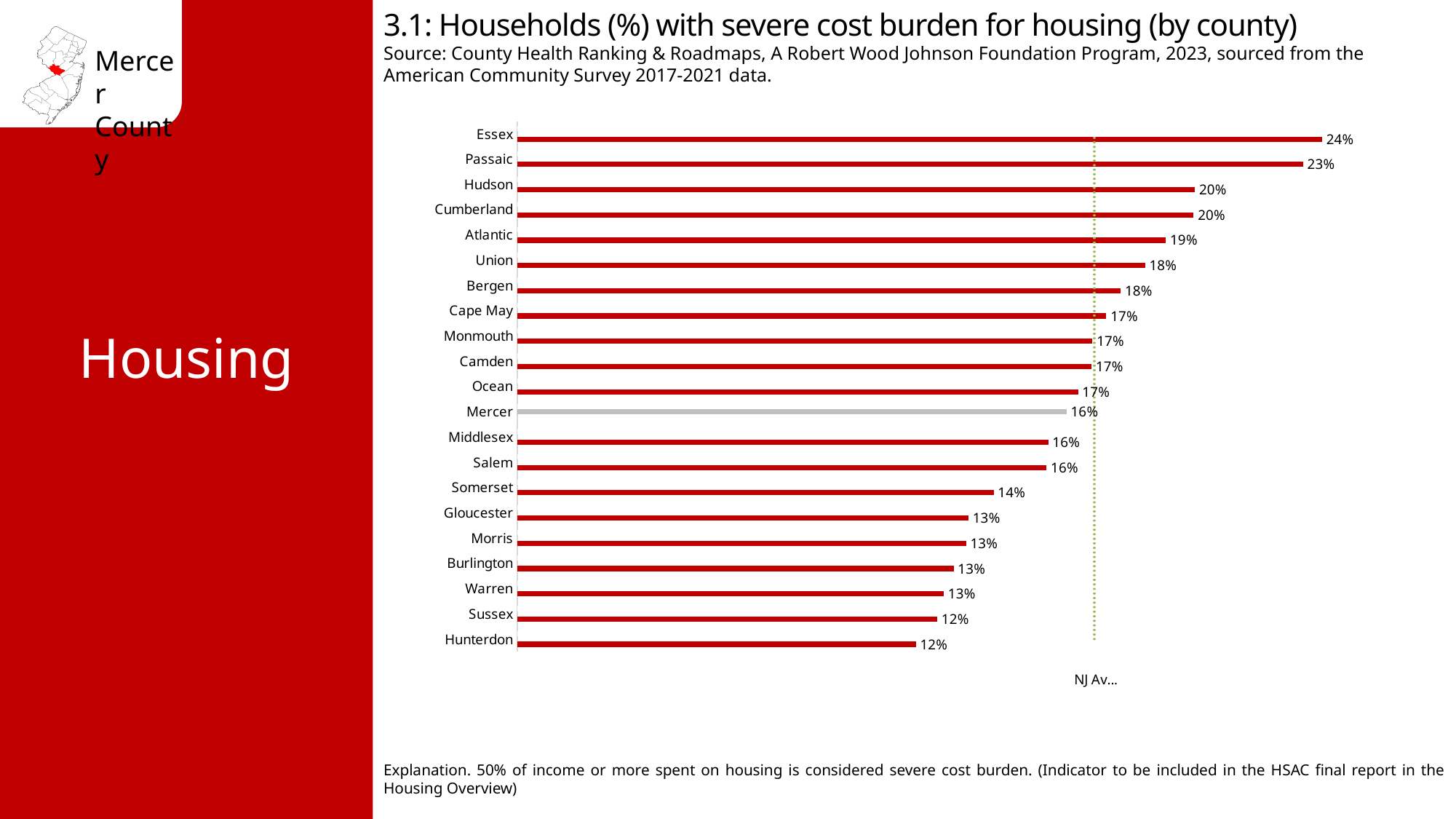
What is the value for Hunterdon? 12% How many counties are shown on the chart? 21 What is the difference between the values for Essex and Mercer? 8 percentage points What is the difference between the values for Passaic and Hudson? 3 percentage points Which county has the highest percentage of households with severe cost burden? Essex Which is larger, the value for Atlantic or the value for Gloucester? Atlantic What is the value for Essex? 24% What is the value for Mercer? 16% What is the lowest value shown on the chart? 12% What is the value for Somerset? 14% Which county's bar is shown in grey instead of red? Mercer What kind of chart is shown on the slide? Bar chart